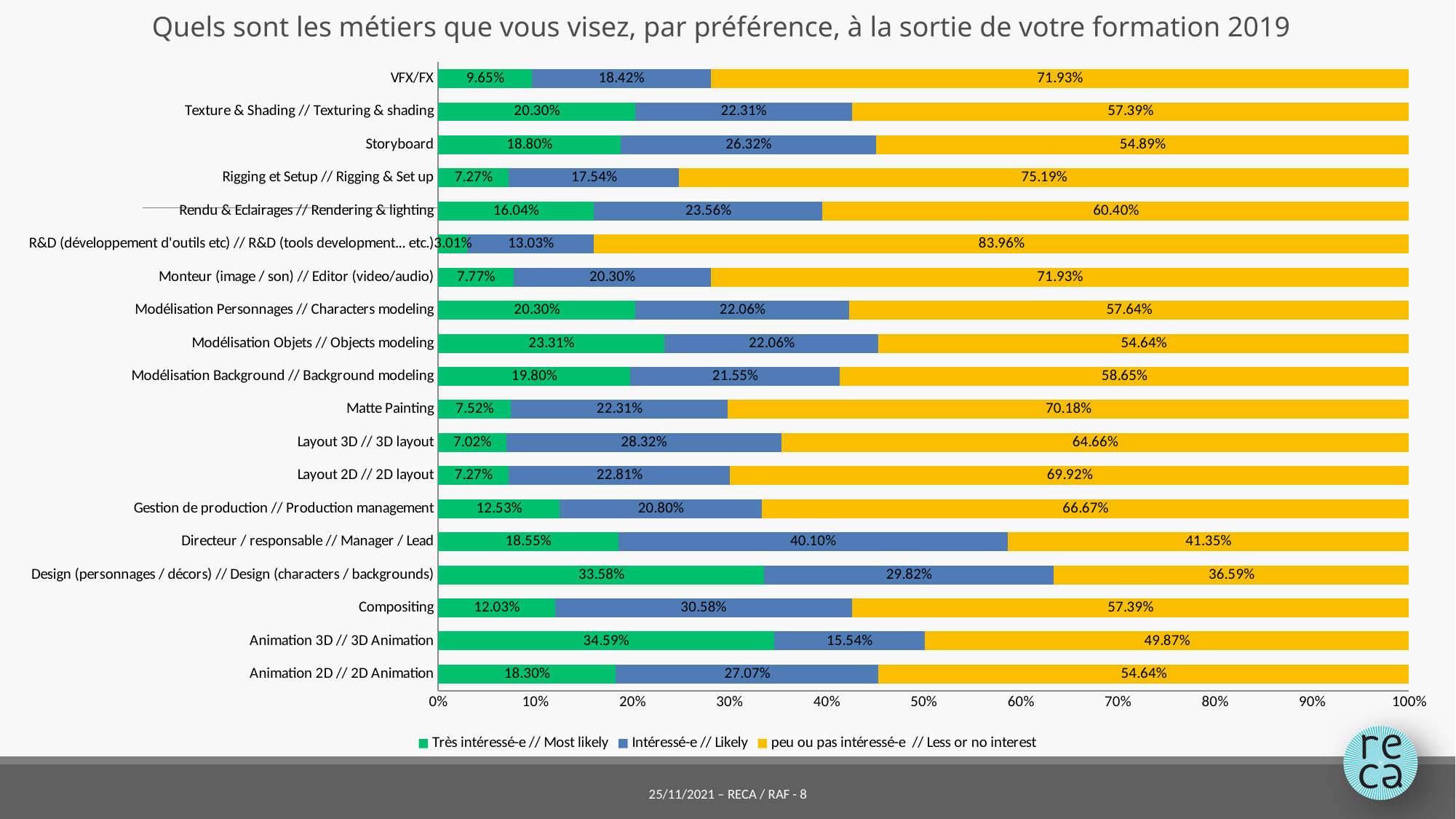
What is the 'peu ou pas intéressé-e // Less or no interest' value for Rigging et Setup // Rigging & Set up? 75.19% What is the 'Intéressé-e // Likely' value for Compositing? 30.58% What type of chart is shown on the slide? Stacked bar chart What is the total of the stacked bar for VFX/FX? 100.00% What is the 'Très intéressé-e // Most likely' value for Animation 3D // 3D Animation? 34.59% Which category has the highest 'Intéressé-e // Likely' value? Directeur / responsable // Manager / Lead How many series does the legend list? 3 How many job categories are plotted on the chart? 19 For Directeur / responsable // Manager / Lead, what is the difference between the 'Intéressé-e // Likely' value and the 'Très intéressé-e // Most likely' value? 21.55% Which category has the lowest 'Très intéressé-e // Most likely' value? R&D (développement d'outils etc) // R&D (tools development... etc.) Which category has the highest 'peu ou pas intéressé-e // Less or no interest' value? R&D (développement d'outils etc) // R&D (tools development... etc.) Which is larger: the 'Très intéressé-e // Most likely' value for Storyboard or for Matte Painting? Storyboard